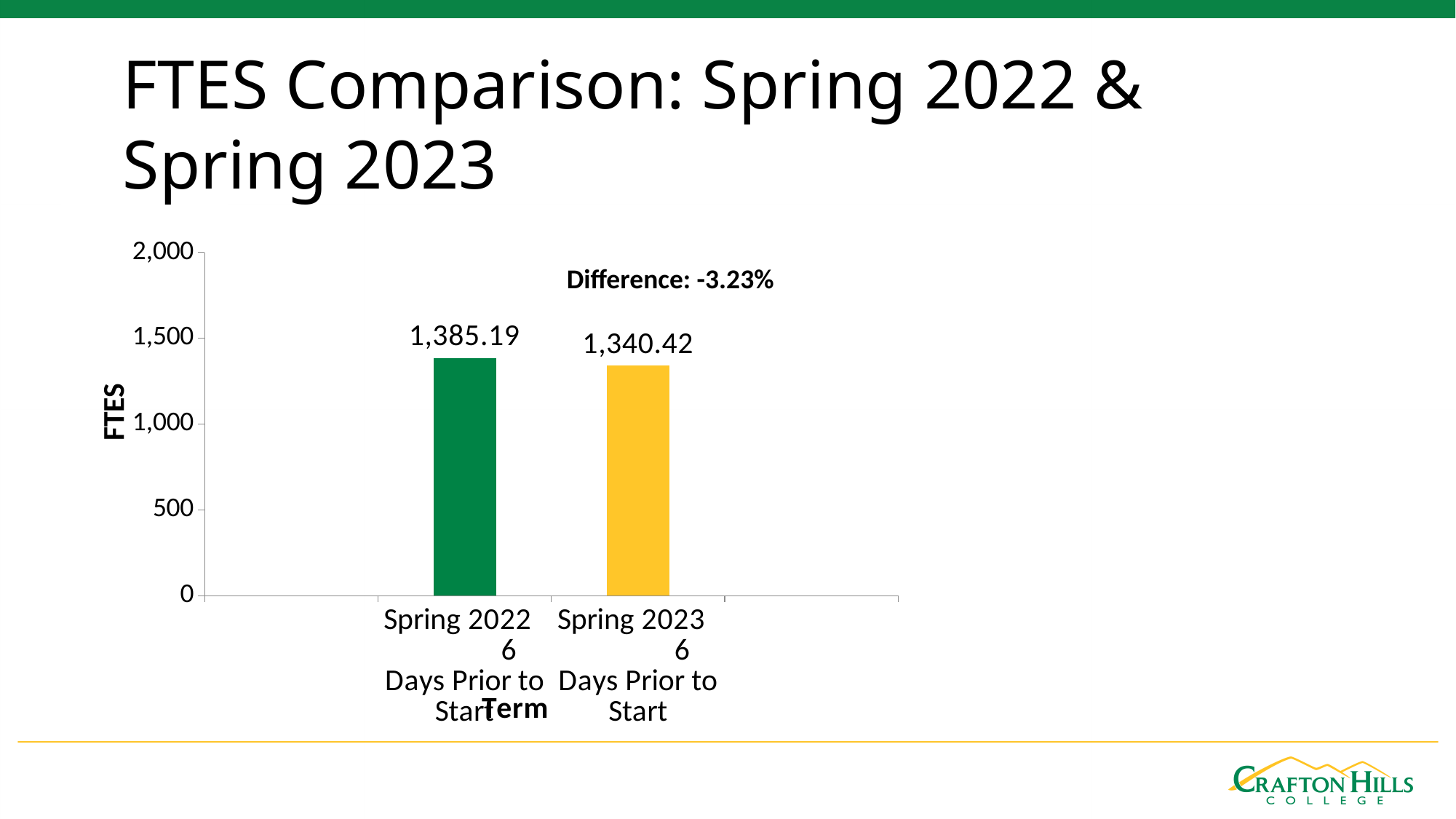
What is the difference in FTES between Spring 2022 and Spring 2023? 44.77 Is the FTES value for Spring 2023 greater or less than 1,500? less Which term has the higher FTES value? Spring 2022 How many bars are plotted in the chart? 2 Is the FTES value for Spring 2022 larger or smaller than the value for Spring 2023? larger Is the FTES value for Spring 2022 greater or less than 1,000? greater Which term has the lower FTES value? Spring 2023 What percentage difference is annotated on the chart? -3.23% What is the label of the vertical axis? FTES What is the FTES value for Spring 2022 (6 Days Prior to Start)? 1,385.19 What is the FTES value for Spring 2023 (6 Days Prior to Start)? 1,340.42 What kind of chart is shown on the slide? bar chart